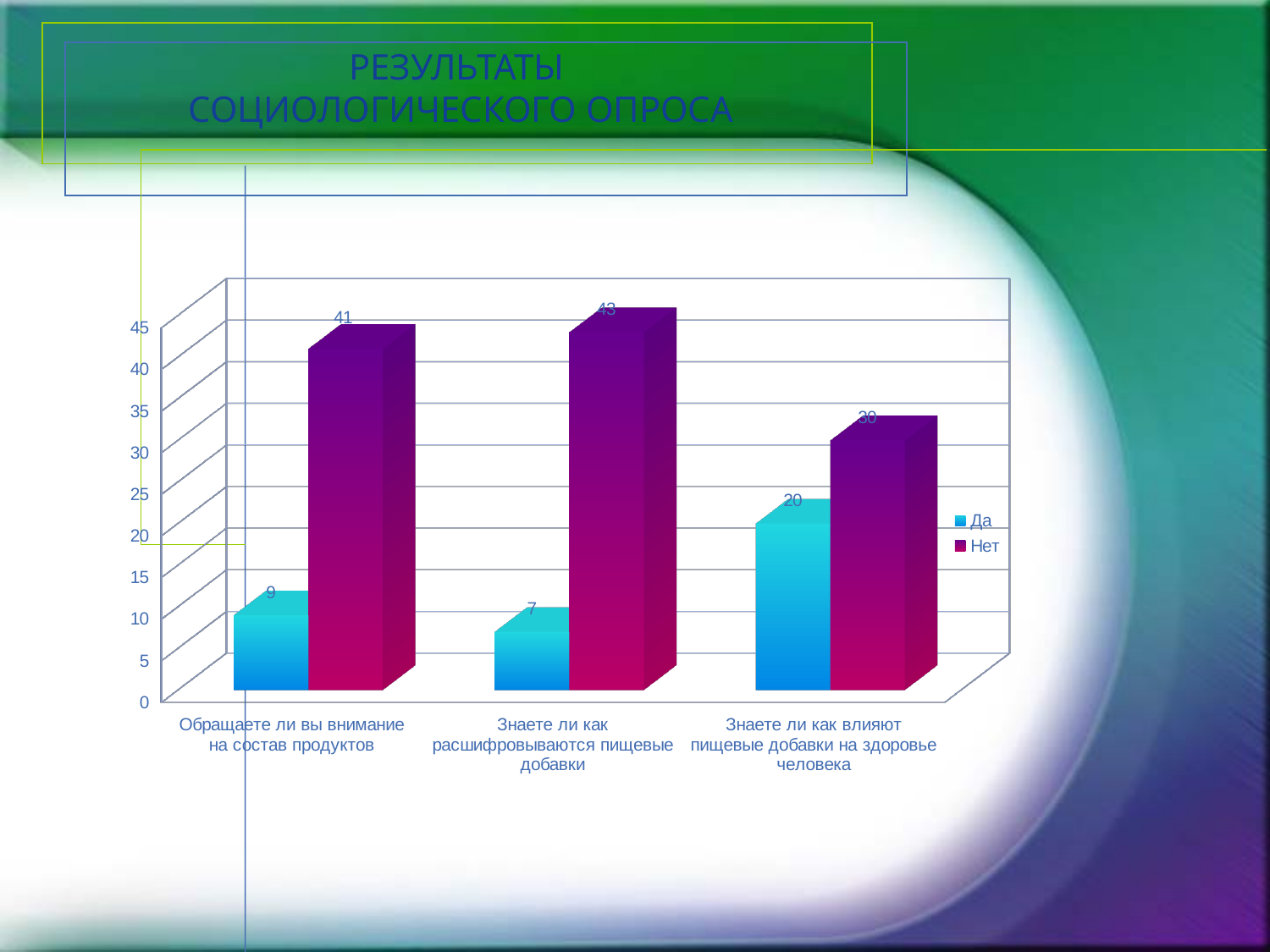
What is the value for "Да" for "Обращаете ли вы внимание на состав продуктов"? 9 What is the value for "Да" for "Знаете ли как влияют пищевые добавки на здоровье человека"? 20 What is the value for "Нет" for "Знаете ли как расшифровываются пищевые добавки"? 43 What is the total of the "Да" and "Нет" values for "Знаете ли как расшифровываются пищевые добавки"? 50 What is the difference between the "Нет" and "Да" values for "Обращаете ли вы внимание на состав продуктов"? 32 How many series does the legend list? 2 How many categories are shown on the x axis? 3 Which category has the highest "Нет" value? Знаете ли как расшифровываются пищевые добавки What kind of chart is shown on the slide? Bar chart Which category has the lowest "Да" value? Знаете ли как расшифровываются пищевые добавки What is the value for "Нет" for "Знаете ли как влияют пищевые добавки на здоровье человека"? 30 Which is larger for "Знаете ли как влияют пищевые добавки на здоровье человека": "Да" or "Нет"? Нет